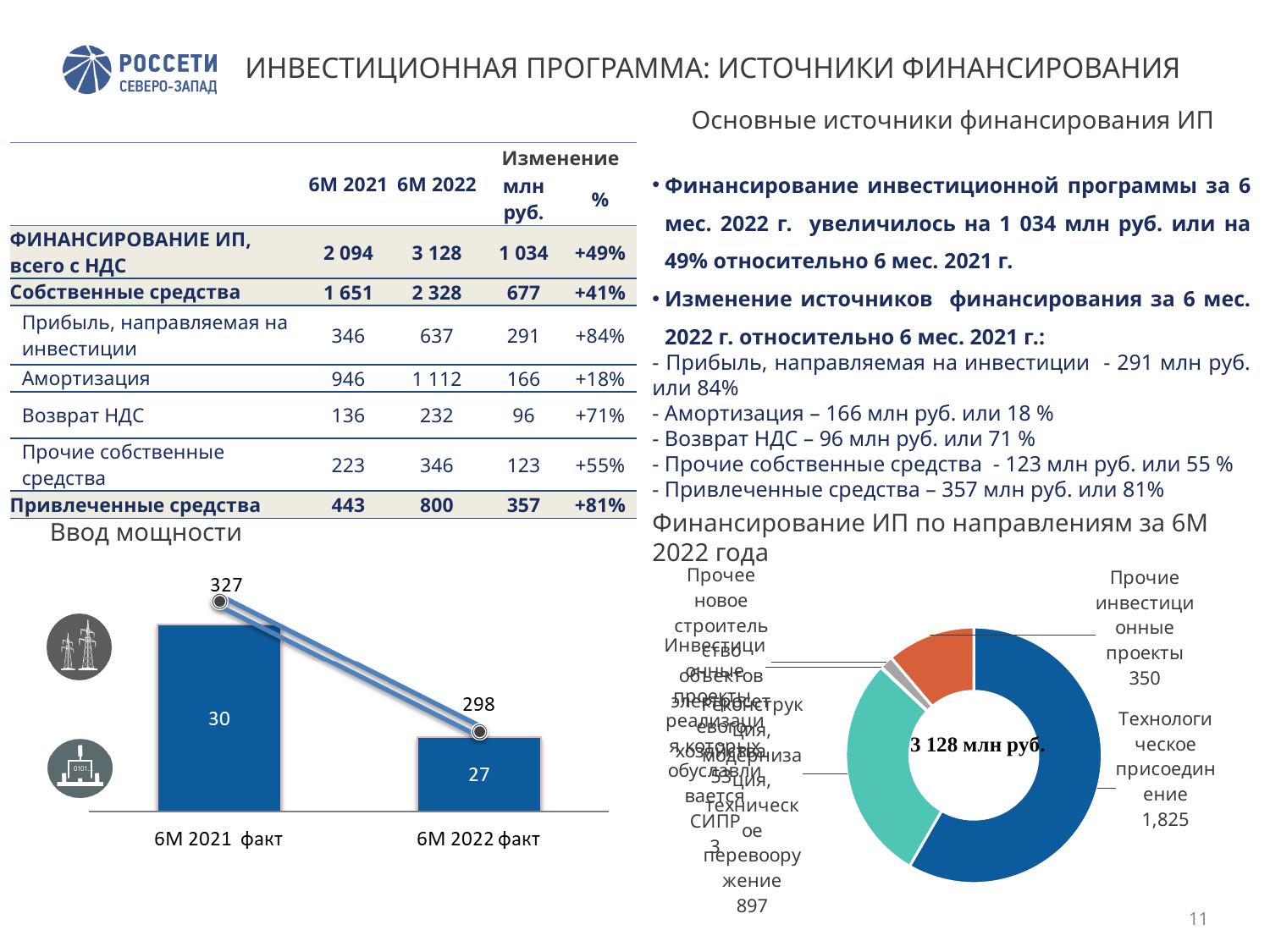
In the 'Ввод мощности' chart, what value does the line point show for 6М 2022 факт? 298 In the 'Ввод мощности' chart, how many categories are shown on the x axis? 2 What kind of chart is the 'Финансирование ИП по направлениям за 6М 2022 года' chart? doughnut (pie) chart In the 'Финансирование ИП по направлениям за 6М 2022 года' chart, what is the value for Технологическое присоединение? 1,825 In the 'Ввод мощности' chart, what is the difference between the bar values for 6М 2021 факт and 6М 2022 факт? 3 In the 'Ввод мощности' chart, what value does the line point show for 6М 2021 факт? 327 In the 'Ввод мощности' chart, do the bar values rise or fall from 6М 2021 факт to 6М 2022 факт? fall In the 'Ввод мощности' chart, by how much does the line value drop from 6М 2021 факт to 6М 2022 факт? 29 In the 'Финансирование ИП по направлениям за 6М 2022 года' chart, what total is printed in the centre of the doughnut? 3 128 млн руб. In the 'Финансирование ИП по направлениям за 6М 2022 года' chart, what is the value for Реконструкция, модернизация, техническое перевооружение? 897 In the 'Ввод мощности' chart, what is the value of the bar for 6М 2021 факт? 30 In the 'Ввод мощности' chart, what is the value of the bar for 6М 2022 факт? 27